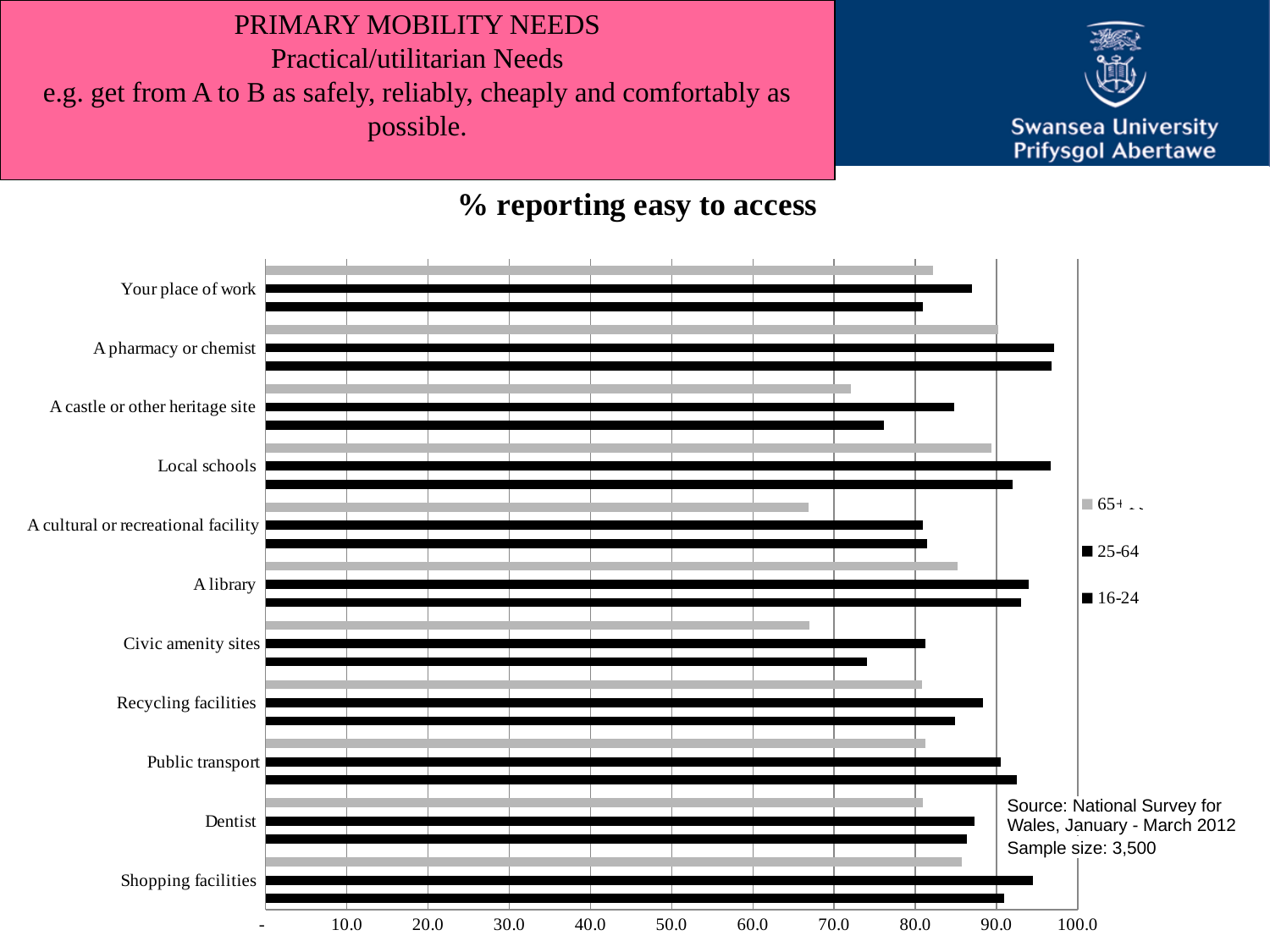
How many series does the chart's legend list? 3 Is the value for the 65+ group for 'A castle or other heritage site' greater or less than 80.0? less What is the title of the chart? % reporting easy to access Which age group is shown in grey in the chart's legend? 65+ For the 65+ group, which is larger: the value for 'A library' or the value for 'A castle or other heritage site'? A library Is the value for the 65+ group for 'A library' greater or less than 80.0? greater Is the value for the 65+ group for 'Civic amenity sites' greater or less than 70.0? less What kind of chart is shown on the slide? Bar chart For the 65+ group, which is larger: the value for 'Your place of work' or the value for 'A cultural or recreational facility'? Your place of work How many categories (facilities) are shown on the chart? 11